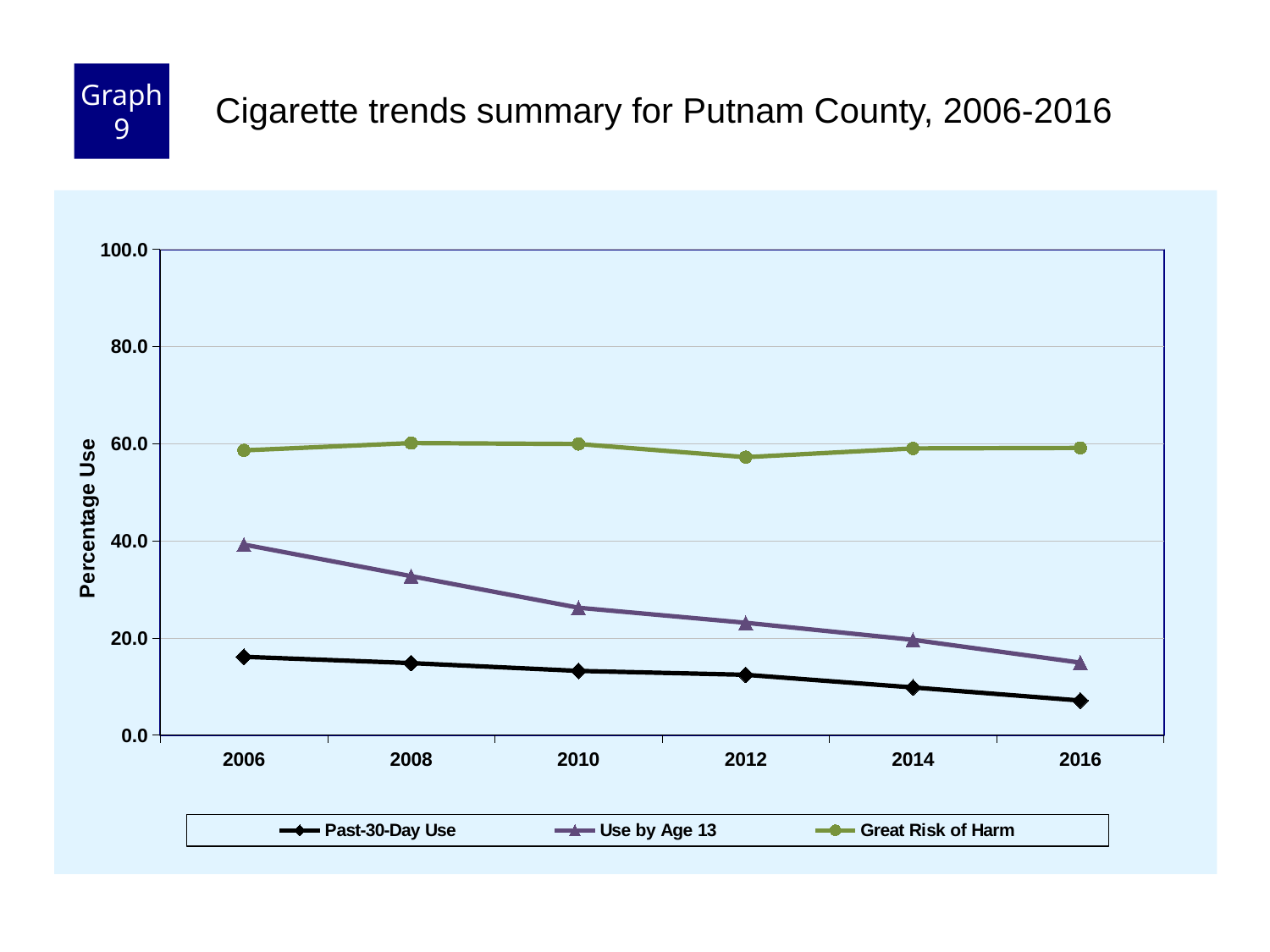
In which year is Use by Age 13 at its highest? 2006 Is the value for Past-30-Day Use in 2006 greater or less than 20.0? less Which series has the highest value in 2016? Great Risk of Harm In which year is Past-30-Day Use at its lowest? 2016 Which is larger in 2012: Use by Age 13 or Past-30-Day Use? Use by Age 13 Does the Past-30-Day Use series rise or fall from 2006 to 2016? Fall How many series does the legend list? 3 Is the value for Use by Age 13 in 2010 greater or less than 20.0? greater Does the Use by Age 13 series rise or fall from 2006 to 2016? Fall Is the value for Use by Age 13 in 2008 greater or less than 40.0? less How many years are plotted along the x axis? 6 What kind of chart is shown on the slide? Line chart